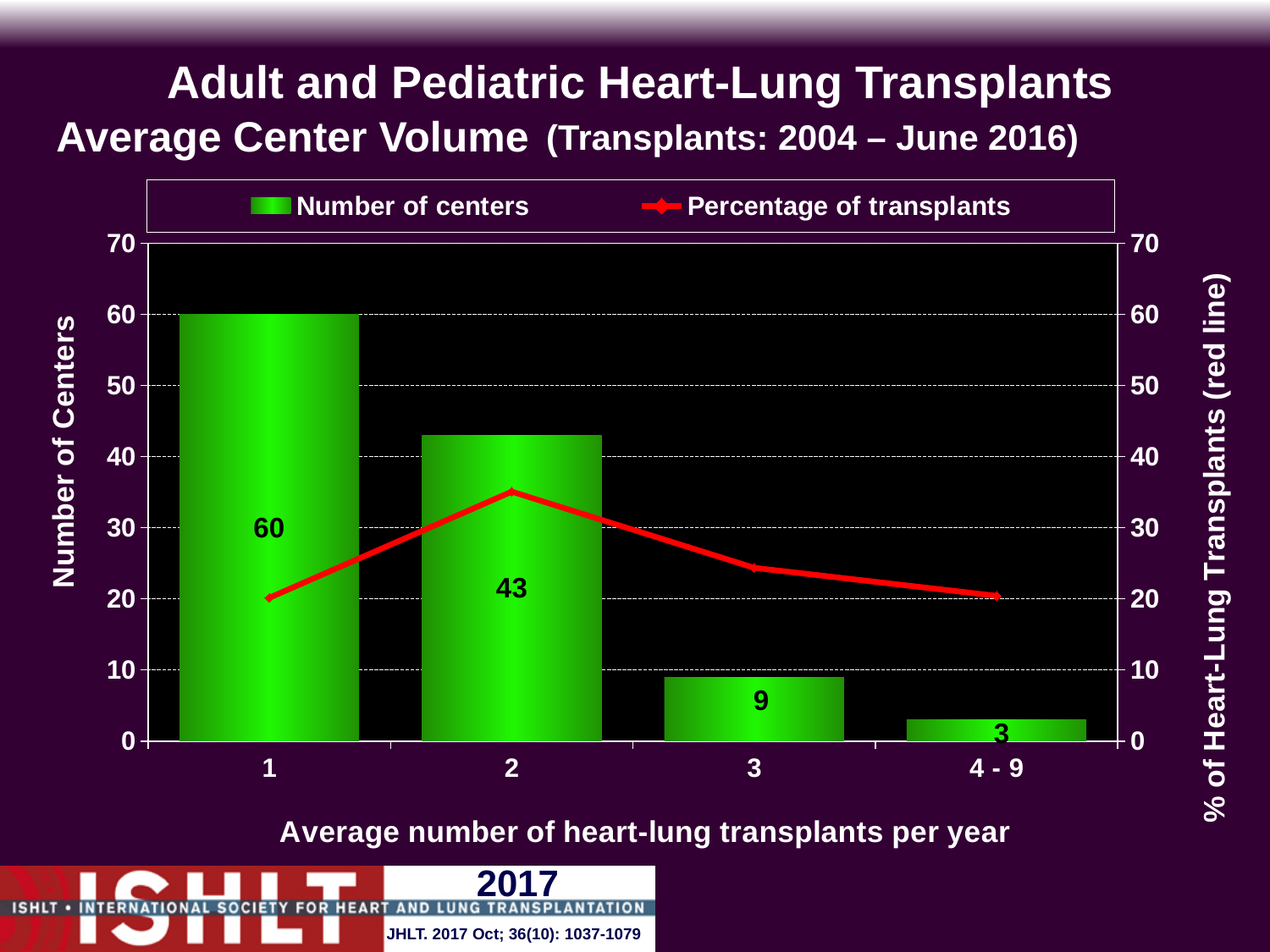
Does the number of centers rise or fall as the average number of transplants per year increases? fall How many series does the legend list? 2 What is the number of centers with an average of 1 heart-lung transplant per year? 60 What is the number of centers in the 4 - 9 transplants per year category? 3 Is the percentage of transplants for the 2 transplants per year category greater or less than 30? greater Is the percentage of transplants for the 3 transplants per year category greater or less than 30? less Which category has the highest number of centers? 1 What is the number of centers with an average of 2 heart-lung transplants per year? 43 What is the difference in number of centers between the 1 and 2 transplants per year categories? 17 Which has more centers: the 3 or the 4 - 9 transplants per year category? 3 Which category has the lowest number of centers? 4 - 9 How many categories are shown on the x axis? 4